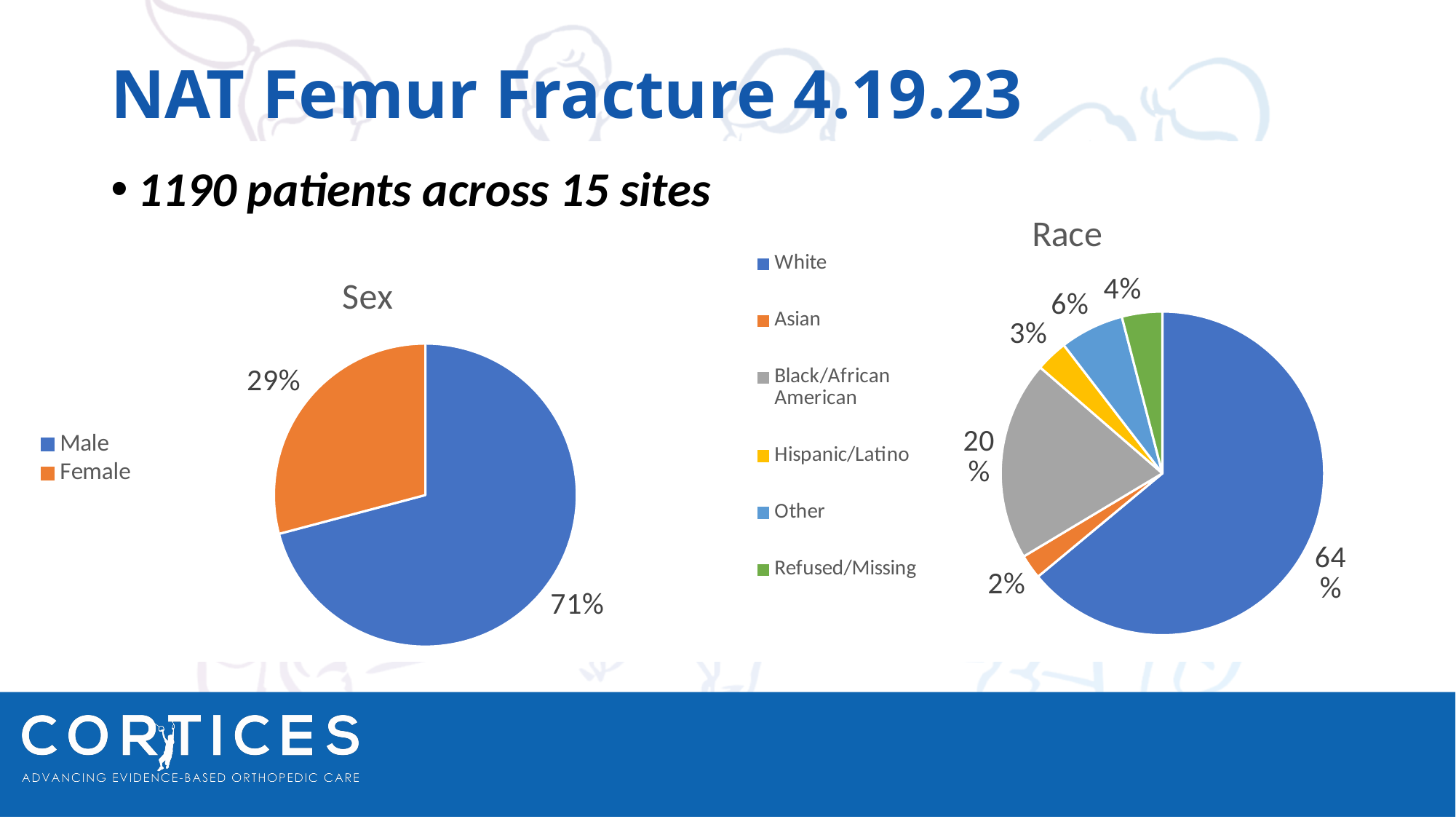
In the Race chart, what is the difference between the White and Black/African American shares? 44% In the Race chart, what share of patients are Hispanic/Latino? 3% In the Sex chart, what is the difference between the Male and Female shares? 42% In the Race chart, what share of patients are Black/African American? 20% In the Race chart, which category has the smallest share? Asian What kind of chart is the Sex chart? Pie chart In the Sex chart, what percentage of patients are male? 71% In the Race chart, which category has the largest share? White In the Race chart, which is larger, the share for Other or the share for Refused/Missing? Other In the Sex chart, what percentage of patients are female? 29% How many categories does the legend of the Race chart list? 6 In the Race chart, what share of patients are White? 64%